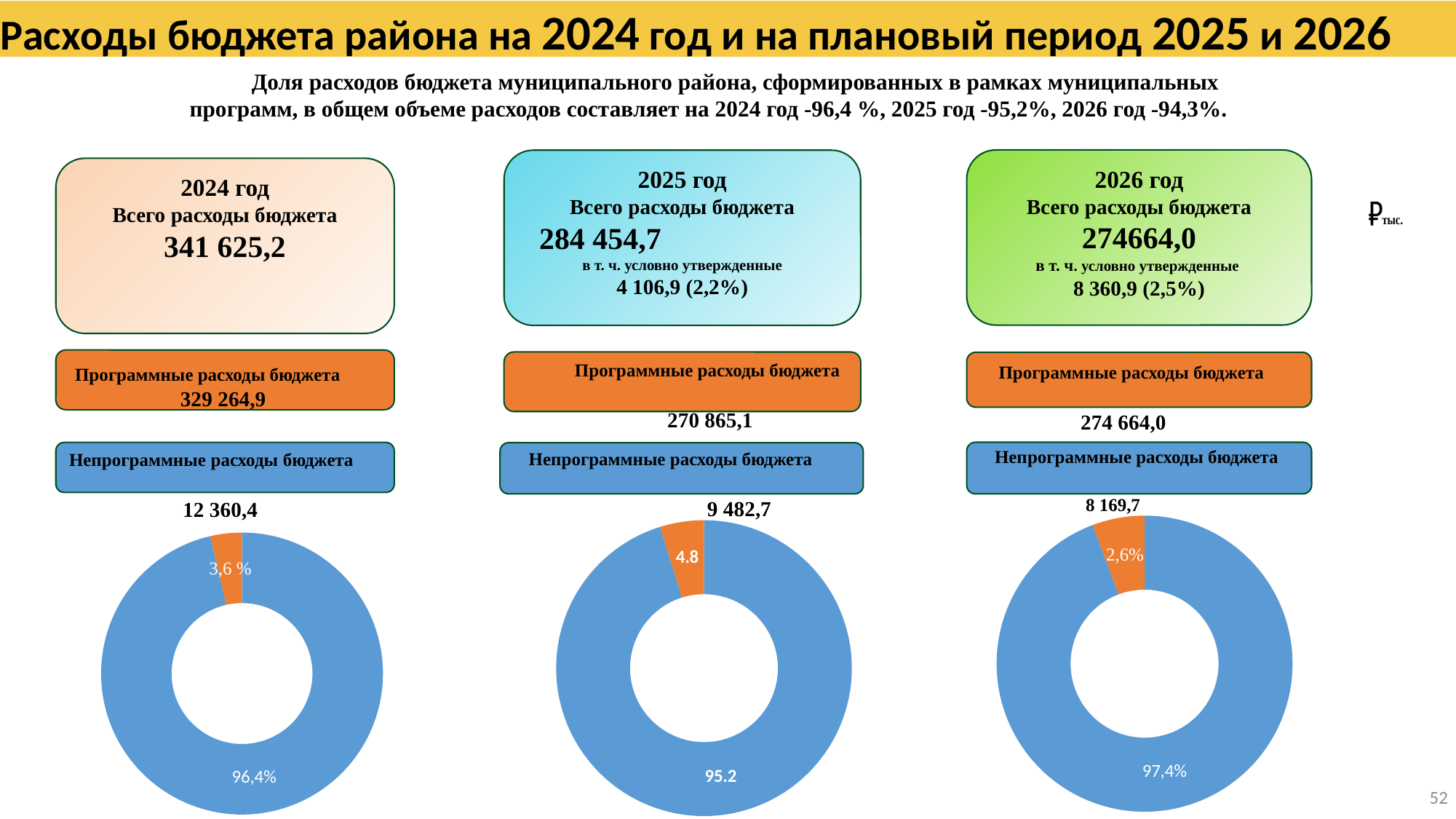
In the left doughnut chart (2024), which slice is larger, the blue one or the orange one? The blue one How many slices does each doughnut chart on the slide have? 2 In the middle doughnut chart (2025), what value is shown on the blue slice? 95.2 In the left doughnut chart (2024), what percentage is shown on the small orange slice? 3,6 % In the left doughnut chart (2024), what percentage is shown on the large blue slice? 96,4% How many doughnut charts are shown on the slide? 3 What type of chart is shown under the 2024 column on the left of the slide? Doughnut (pie) chart In the right doughnut chart (2026), what percentage is shown on the blue slice? 97,4% In the right doughnut chart (2026), what percentage is shown on the orange slice? 2,6% In the middle doughnut chart (2025), what value is shown on the orange slice? 4.8 In the left doughnut chart (2024), what is the difference between the blue slice's percentage and the orange slice's percentage? 92,8 percentage points Which colour is used for the larger slice in all three doughnut charts? Blue